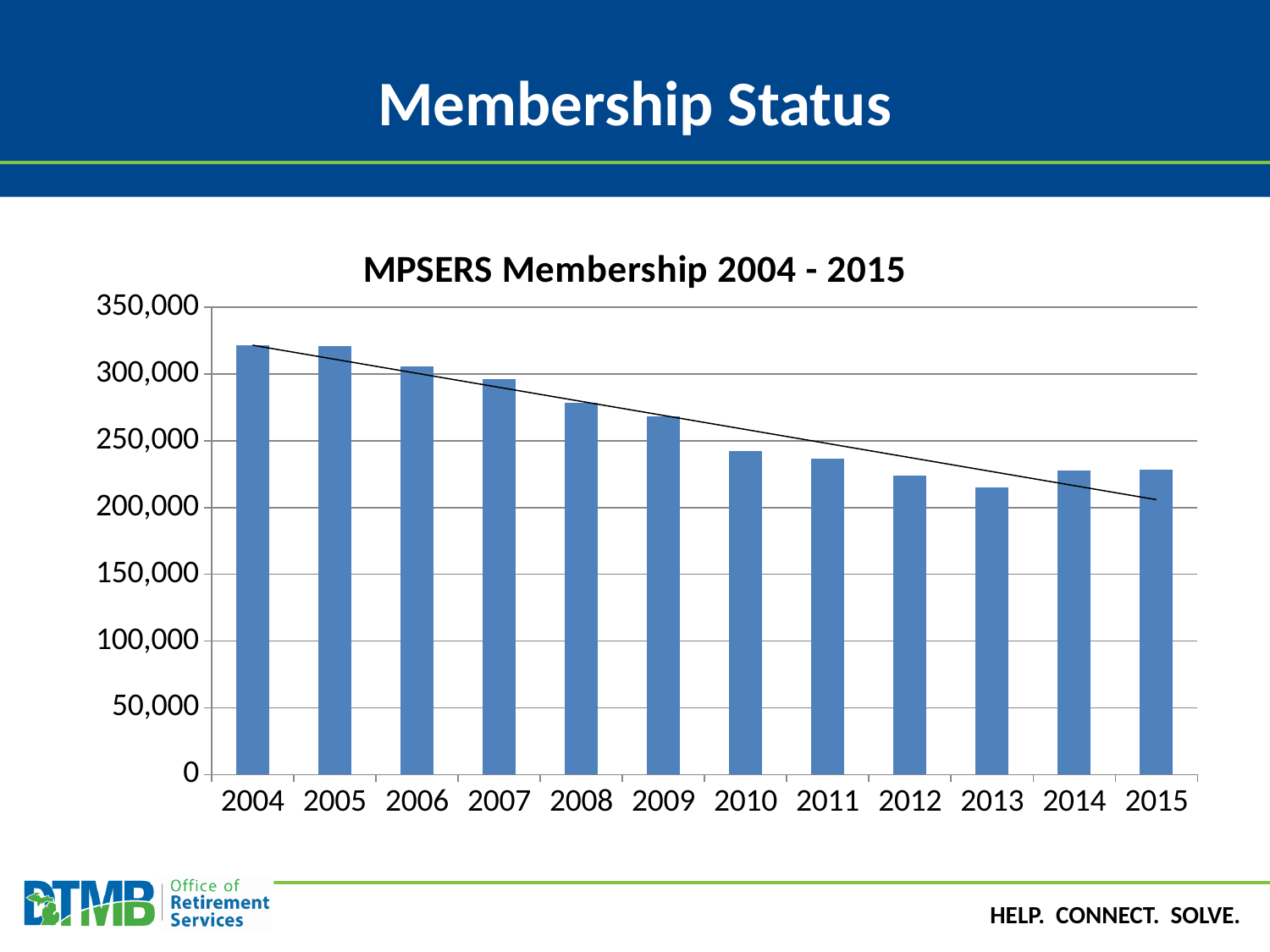
What is the title of the chart? MPSERS Membership 2004 - 2015 What kind of chart is shown on the slide? bar chart Overall, does membership rise or fall from 2004 to 2015? fall Is the membership value for 2013 greater or less than 250,000? less Which year has the larger membership, 2008 or 2012? 2008 Is the membership value for 2010 greater or less than 250,000? less Is the membership value for 2004 greater or less than 300,000? greater Which year has the lowest membership in the chart? 2013 Which year has the larger membership, 2004 or 2015? 2004 How many years are shown on the x axis of the chart? 12